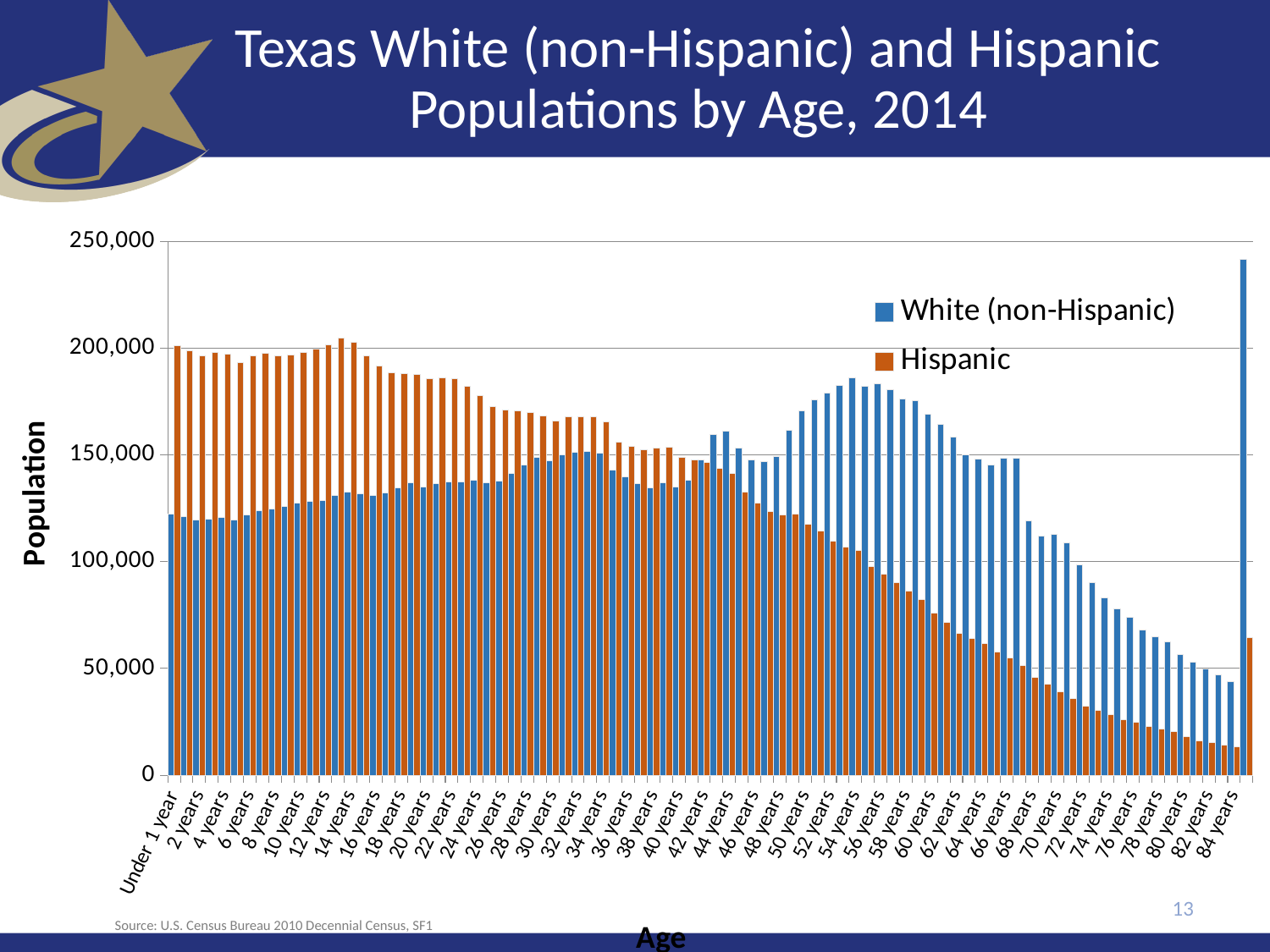
How many series does the legend list? 2 Do the Hispanic values generally rise or fall along the x axis from 20 years to 84 years? fall What kind of chart is shown on the slide? Bar chart Is the White (non-Hispanic) value for 84 years greater or less than 50,000? less At 54 years, which is larger: the White (non-Hispanic) value or the Hispanic value? White (non-Hispanic) At 2 years, which is larger: the White (non-Hispanic) value or the Hispanic value? Hispanic Is the Hispanic value for 70 years greater or less than 50,000? less Is the Hispanic value for 2 years greater or less than 150,000? greater What is the label of the vertical axis of the chart? Population Which two series are listed in the chart legend? White (non-Hispanic) and Hispanic